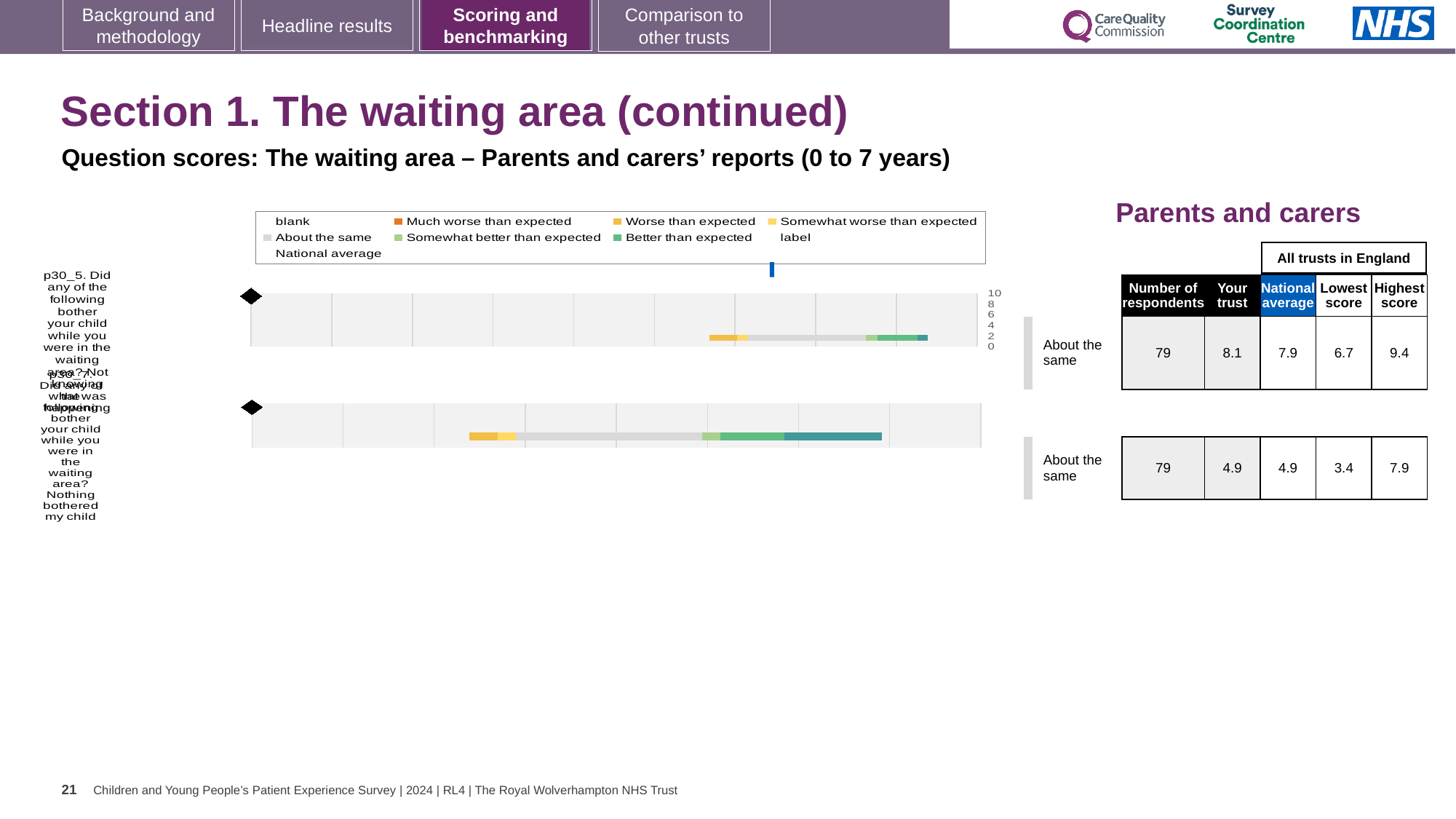
For the top chart (p30_5), which is larger: the 'Your trust' score or the national average? Your trust For the bottom chart (p30_7), what is the lowest score among all trusts in England? 3.4 What kind of chart is used to show the question scores on this slide? bar chart For the top chart (p30_5), what is the national average score shown in the table? 7.9 What benchmark category is the trust's result for the bottom chart (p30_7) labelled as? About the same How many respondents are shown for the top chart (p30_5)? 79 For the bottom chart (p30_7, nothing bothered my child), what is the 'Your trust' score shown in the table? 4.9 How many questions (chart rows) are plotted on this slide? 2 For the top chart (p30_5), what is the difference between the highest score (9.4) and the lowest score (6.7) among all trusts? 2.7 For the bottom chart (p30_7), what is the difference between the highest score (7.9) and the lowest score (3.4) among all trusts? 4.5 What is the maximum value shown on the score axis of the charts? 10 For the top chart (p30_5, not knowing what was happening), what is the 'Your trust' score shown in the table? 8.1